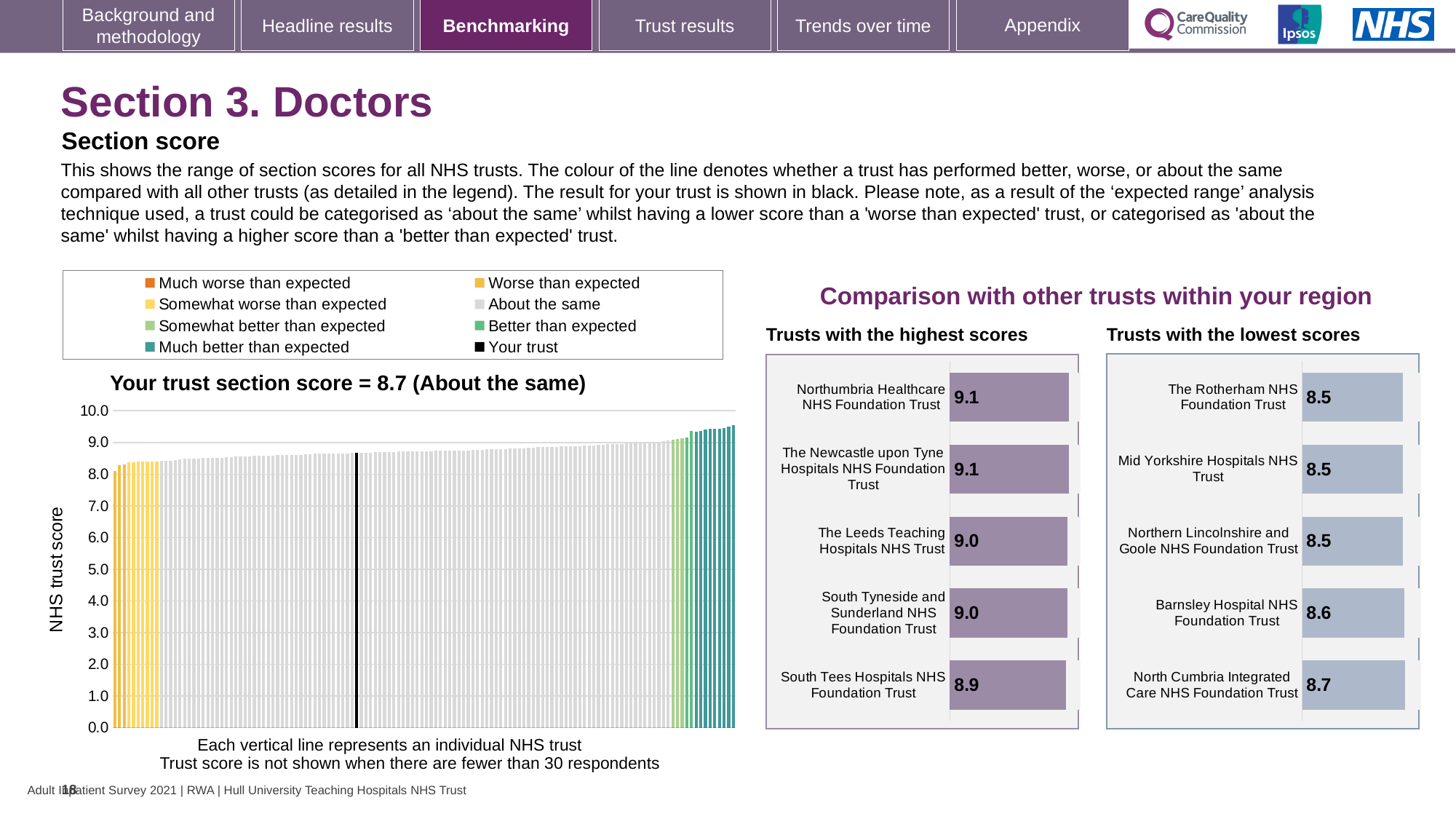
In the 'Trusts with the highest scores' chart, what is the score for The Leeds Teaching Hospitals NHS Trust? 9.0 In the 'Your trust section score' chart, is the value of the tallest bar greater or less than 9.0? greater In the 'Trusts with the highest scores' chart, what is the difference between the scores of Northumbria Healthcare NHS Foundation Trust and South Tees Hospitals NHS Foundation Trust? 0.2 In the 'Your trust section score' chart, what is the section score for your trust? 8.7 In the 'Trusts with the lowest scores' chart, which trust has the highest score? North Cumbria Integrated Care NHS Foundation Trust In the 'Your trust section score' chart, do the trust scores rise or fall from left to right? rise In the 'Trusts with the lowest scores' chart, how many trusts are shown? 5 In the 'Your trust section score' chart, how many entries does the legend list? 8 In the 'Trusts with the lowest scores' chart, which has the larger score: Barnsley Hospital NHS Foundation Trust or The Rotherham NHS Foundation Trust? Barnsley Hospital NHS Foundation Trust In the 'Trusts with the highest scores' chart, which trust has the lowest score? South Tees Hospitals NHS Foundation Trust In the 'Your trust section score' chart, what is the label on the vertical axis? NHS trust score In the 'Your trust section score' chart, what kind of chart is shown? bar chart